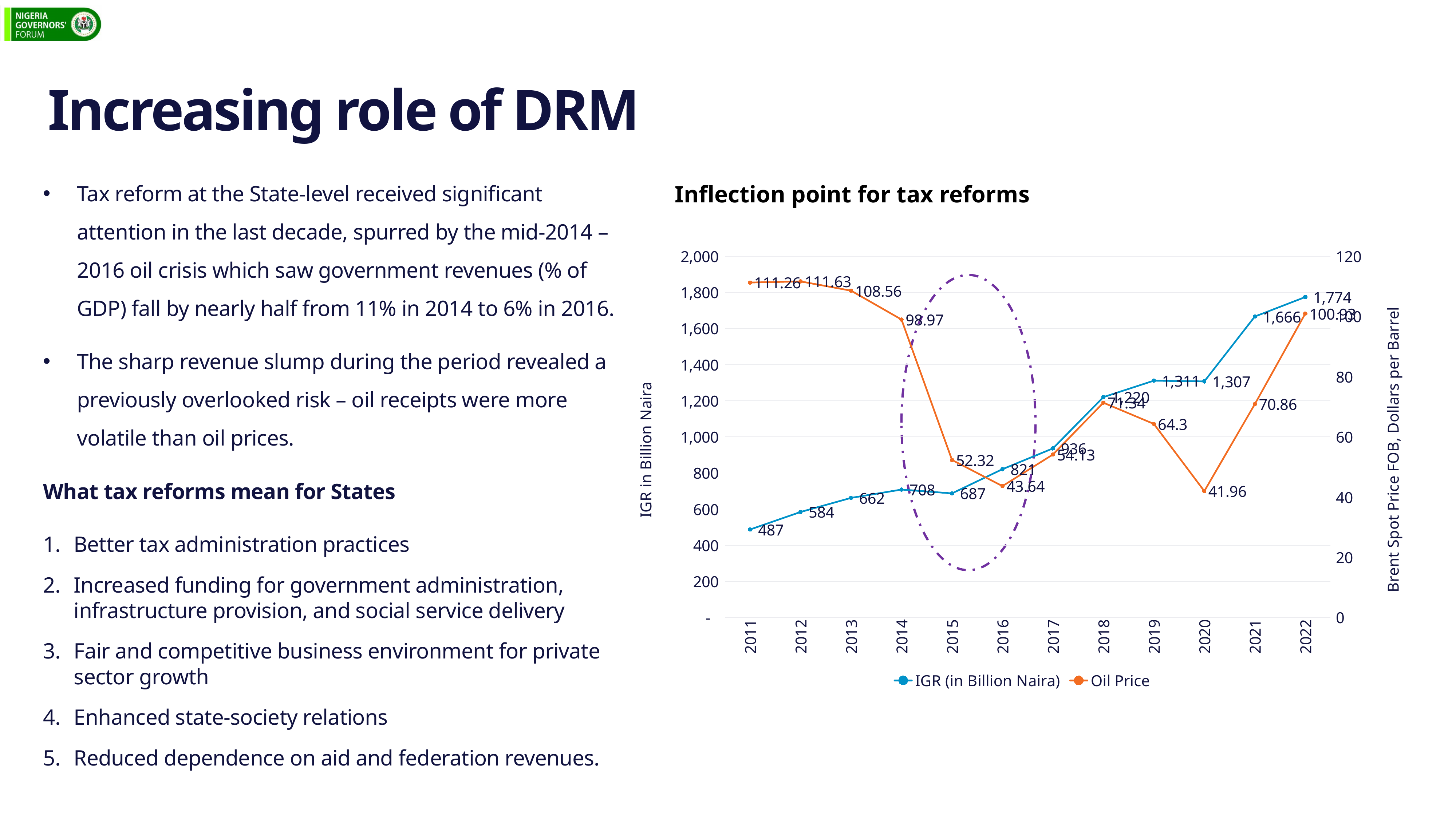
Which year has the larger IGR (in Billion Naira) value, 2015 or 2016? 2016 What is the difference between the IGR (in Billion Naira) values for 2022 and 2011? 1,287 What kind of chart is shown on the slide? line chart What is the Oil Price value for 2020? 41.96 How many series does the legend of the chart list? 2 What is the IGR (in Billion Naira) value for 2011? 487 What is the Oil Price value for 2015? 52.32 How many years are shown on the x axis of the chart? 12 What is the title of the chart? Inflection point for tax reforms In which year is the Oil Price lowest? 2020 In which year is the IGR (in Billion Naira) highest? 2022 What is the IGR (in Billion Naira) value for 2022? 1,774